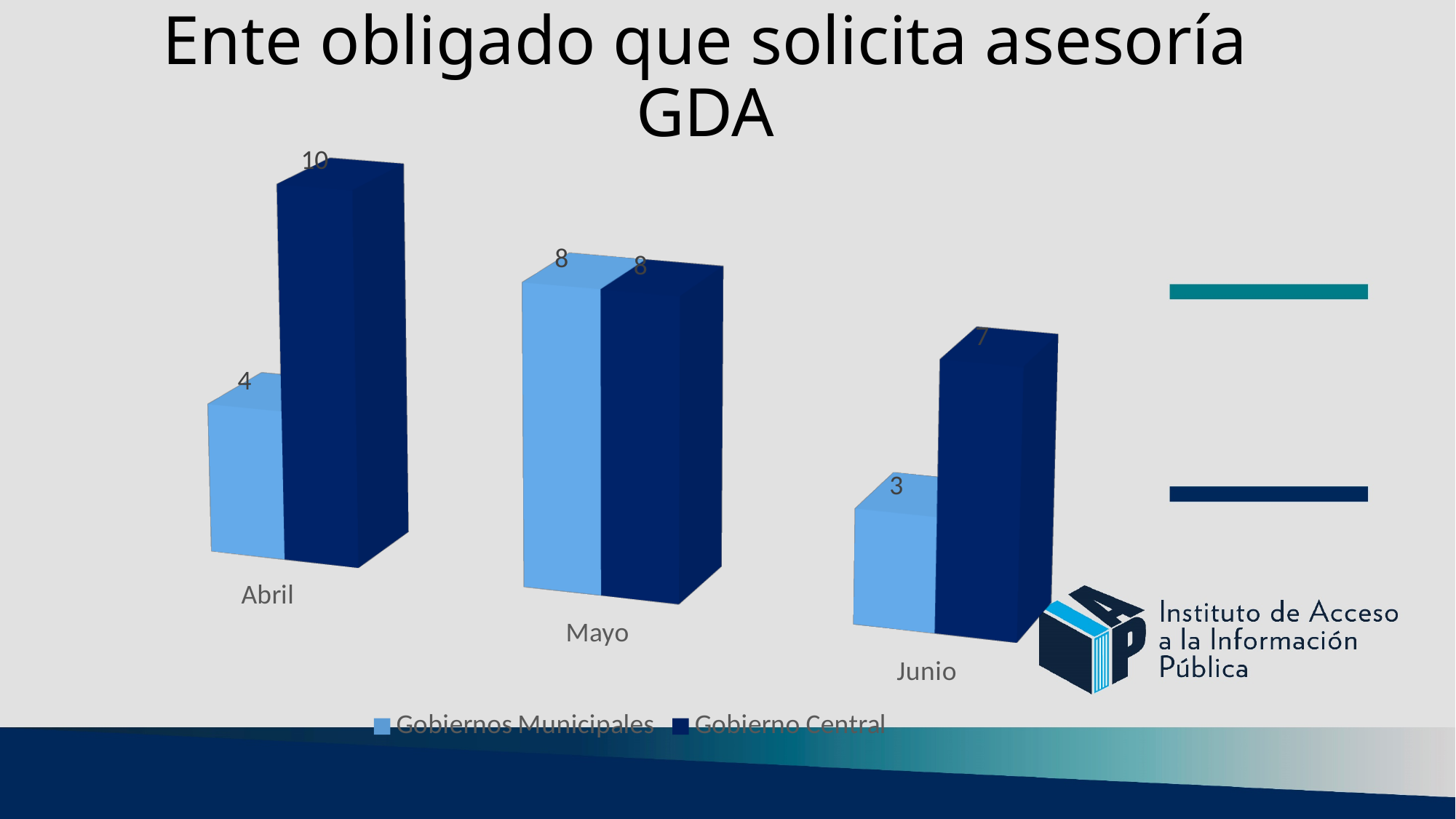
What is the value for Gobiernos Municipales in Junio? 3 What is the value for Gobierno Central in Abril? 10 In which month is the Gobierno Central value highest? Abril Which is larger in Junio, Gobierno Central or Gobiernos Municipales? Gobierno Central What is the title of the chart? Ente obligado que solicita asesoría GDA In which month is the Gobiernos Municipales value lowest? Junio What is the value for Gobierno Central in Junio? 7 How many series does the legend list? 2 How many months are shown on the x axis? 3 What is the difference between Gobierno Central and Gobiernos Municipales in Abril? 6 What is the value for Gobiernos Municipales in Abril? 4 What kind of chart is shown on the slide? Bar chart